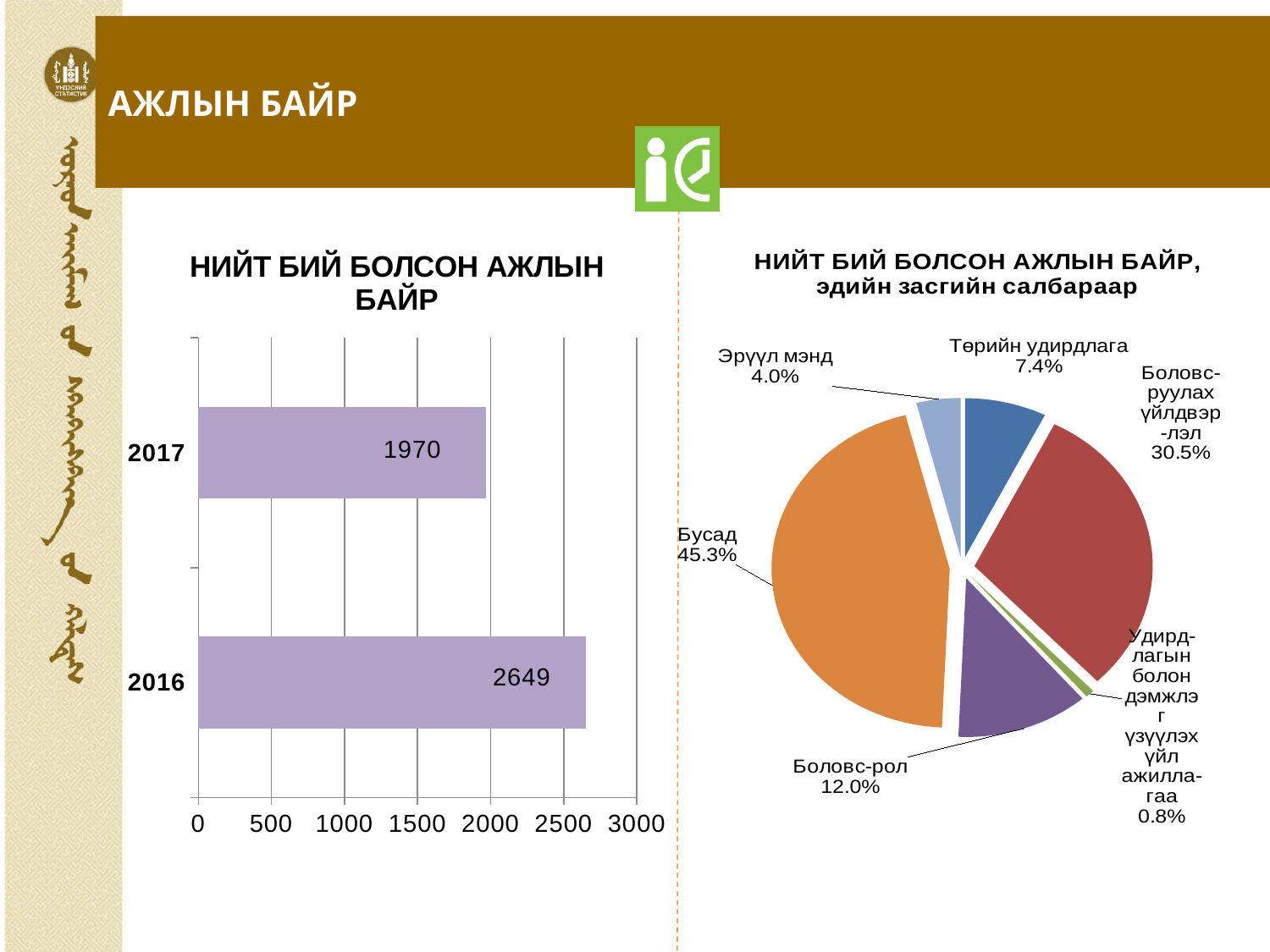
In the pie chart on the right, what share does 'Бусад' have? 45.3% What kind of chart is the chart on the left of the slide? Bar chart In the pie chart on the right, what share does 'Боловсруулах үйлдвэрлэл' have? 30.5% In the pie chart on the right, which is larger: 'Боловсрол' or 'Төрийн удирдлага'? Боловсрол In the pie chart on the right, which slice is the smallest? Удирдлагын болон дэмжлэг үзүүлэх үйл ажиллагаа In the bar chart on the left, how many bars are shown? 2 In the bar chart on the left, what is the difference between the 2016 and 2017 values? 679 In the pie chart on the right, what share does 'Эрүүл мэнд' have? 4.0% In the bar chart titled 'НИЙТ БИЙ БОЛСОН АЖЛЫН БАЙР', what is the value for 2017? 1970 In the pie chart on the right, how many slices are there? 6 In the bar chart on the left, which year has the higher value? 2016 In the bar chart titled 'НИЙТ БИЙ БОЛСОН АЖЛЫН БАЙР', what is the value for 2016? 2649